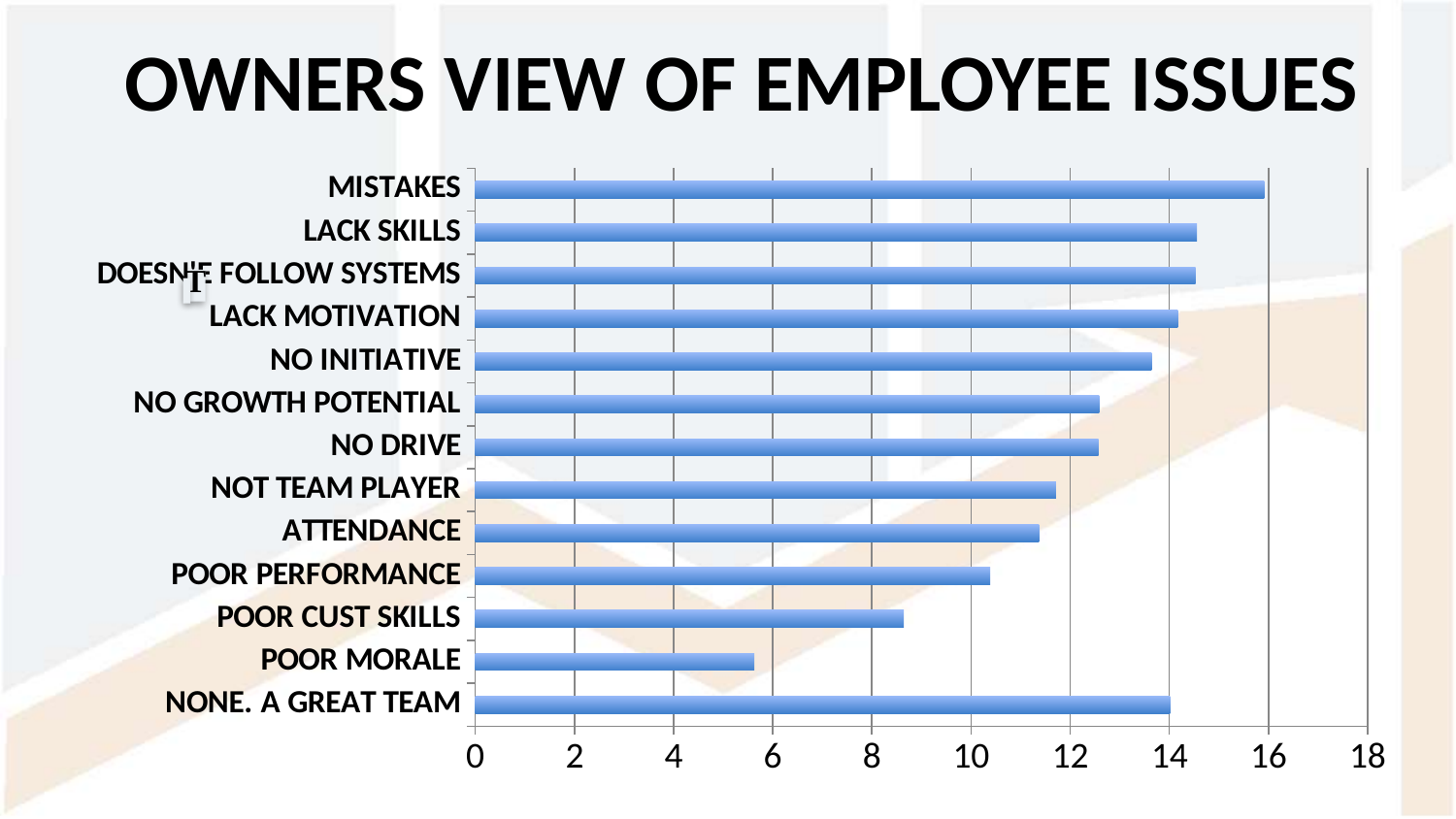
Is the value for MISTAKES greater or less than 14? greater How many categories are plotted in the chart? 13 What kind of chart is shown on the slide? bar chart Which is larger, the value for POOR PERFORMANCE or the value for POOR CUST SKILLS? POOR PERFORMANCE Is the value for POOR CUST SKILLS greater or less than 10? less What is the maximum value shown on the horizontal axis? 18 Which category has the lowest value? POOR MORALE Which is larger, the value for NO INITIATIVE or the value for ATTENDANCE? NO INITIATIVE Is the value for POOR MORALE greater or less than 6? less What is the title of the chart? OWNERS VIEW OF EMPLOYEE ISSUES Which category has the highest value? MISTAKES